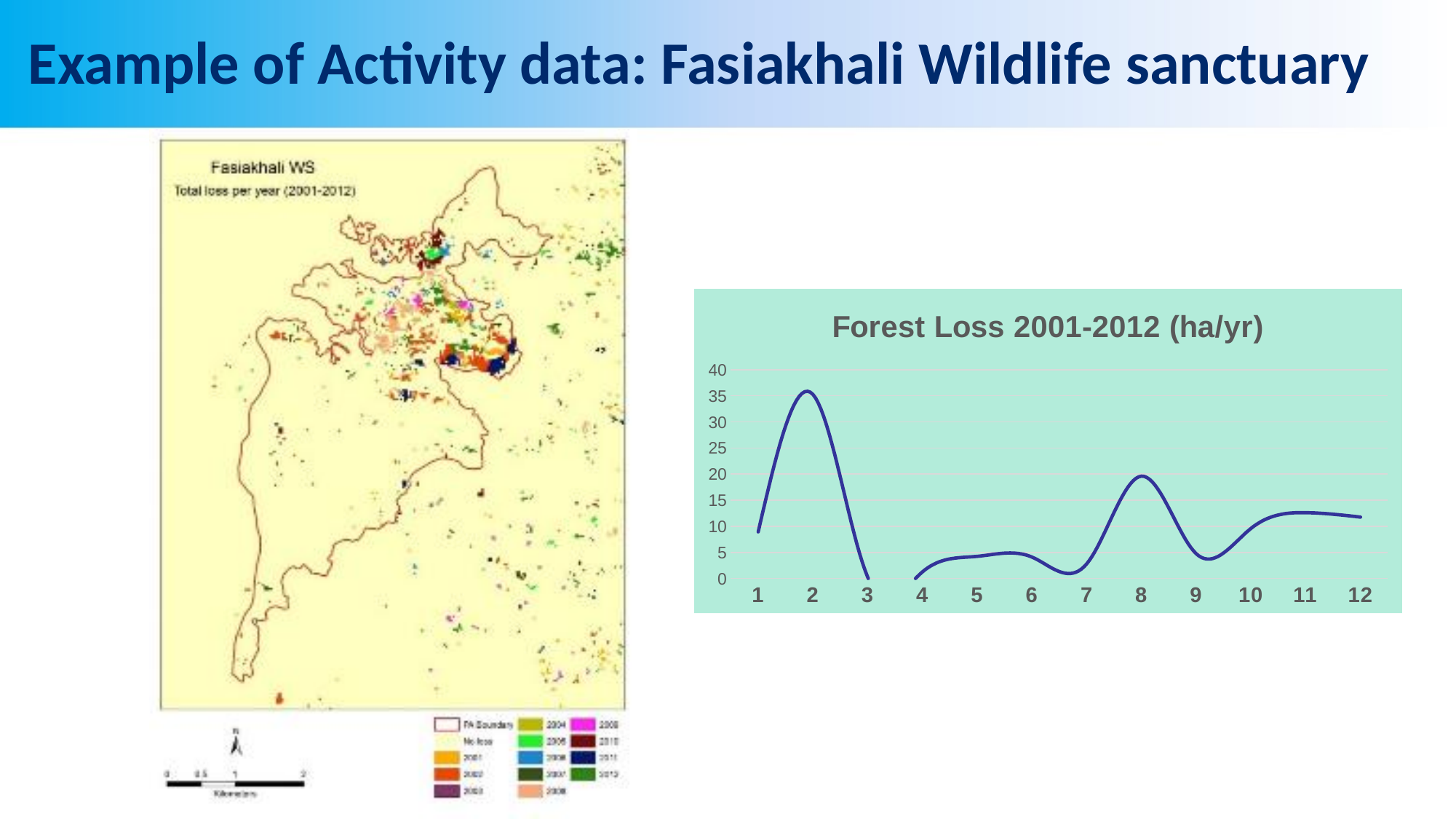
What is the title of the chart on the right of the slide? Forest Loss 2001-2012 (ha/yr) In the Forest Loss 2001-2012 (ha/yr) chart, is the value at point 8 greater or less than 15? greater In the Forest Loss 2001-2012 (ha/yr) chart, is the value at point 2 greater or less than 30? greater What is the highest value shown on the y axis of the Forest Loss 2001-2012 (ha/yr) chart? 40 How many points are labelled along the x axis of the Forest Loss 2001-2012 (ha/yr) chart? 12 In the Forest Loss 2001-2012 (ha/yr) chart, is the value at point 5 greater or less than 10? less In the Forest Loss 2001-2012 (ha/yr) chart, which has the larger value, point 7 or point 11? 11 In the Forest Loss 2001-2012 (ha/yr) chart, which has the larger value, point 2 or point 8? 2 In the Forest Loss 2001-2012 (ha/yr) chart, does the value rise or fall from point 2 to point 3? fall What kind of chart is the Forest Loss 2001-2012 (ha/yr) chart? line chart In the Forest Loss 2001-2012 (ha/yr) chart, which x-axis point has the highest value? 2